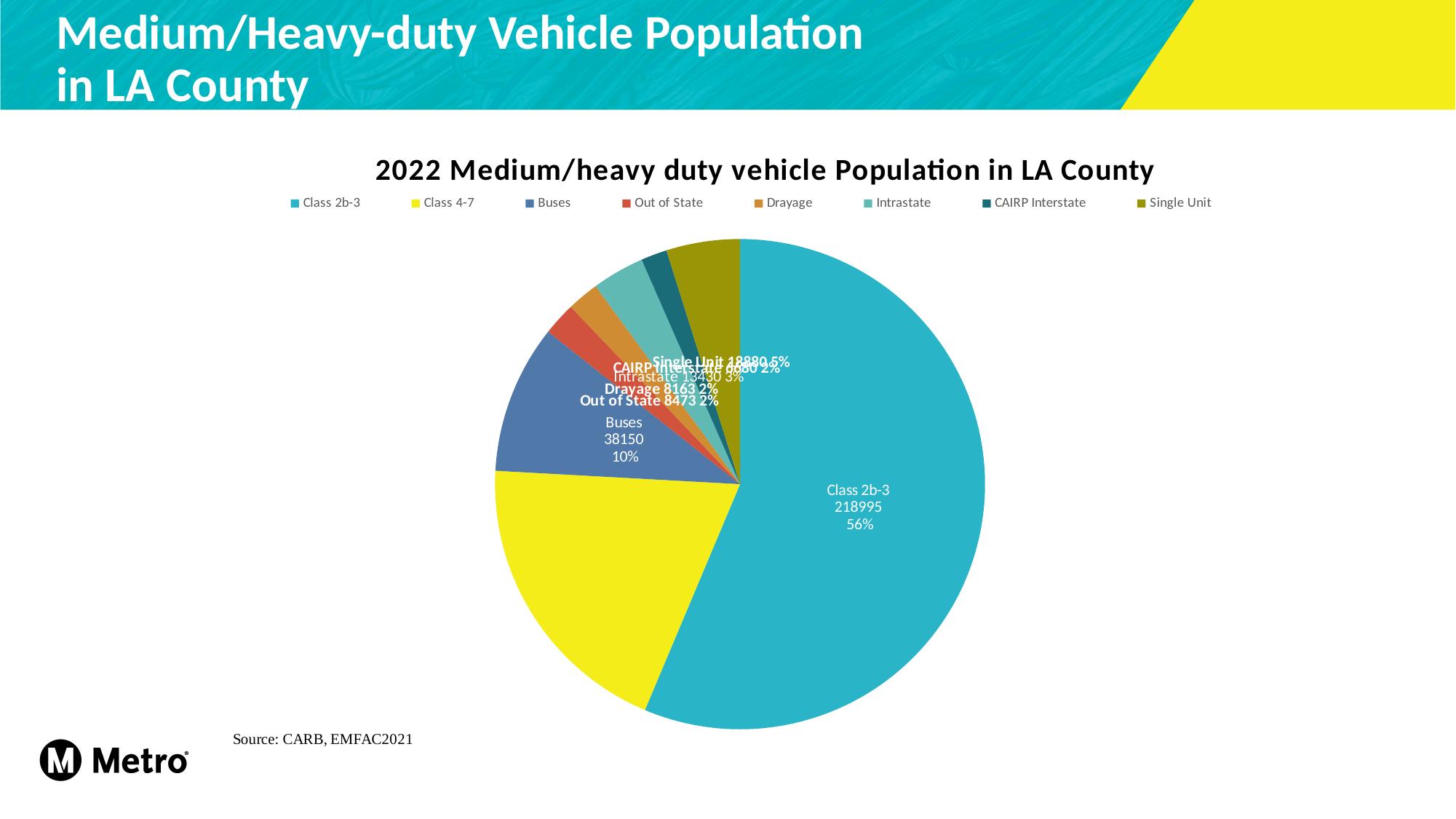
What is the value for Single Unit? 18880 What share of the pie does Class 2b-3 represent? 56% What is the value for Buses? 38150 Which is larger, the value for Out of State or the value for Drayage? Out of State What kind of chart is shown on the slide? pie chart Which category has the largest slice of the pie? Class 2b-3 What is the difference between the values for Buses and Single Unit? 19270 What is the title of the chart? 2022 Medium/heavy duty vehicle Population in LA County What is the value for Class 2b-3? 218995 What share of the pie do Buses represent? 10% How many categories does the legend list? 8 What is the value for Intrastate? 13430